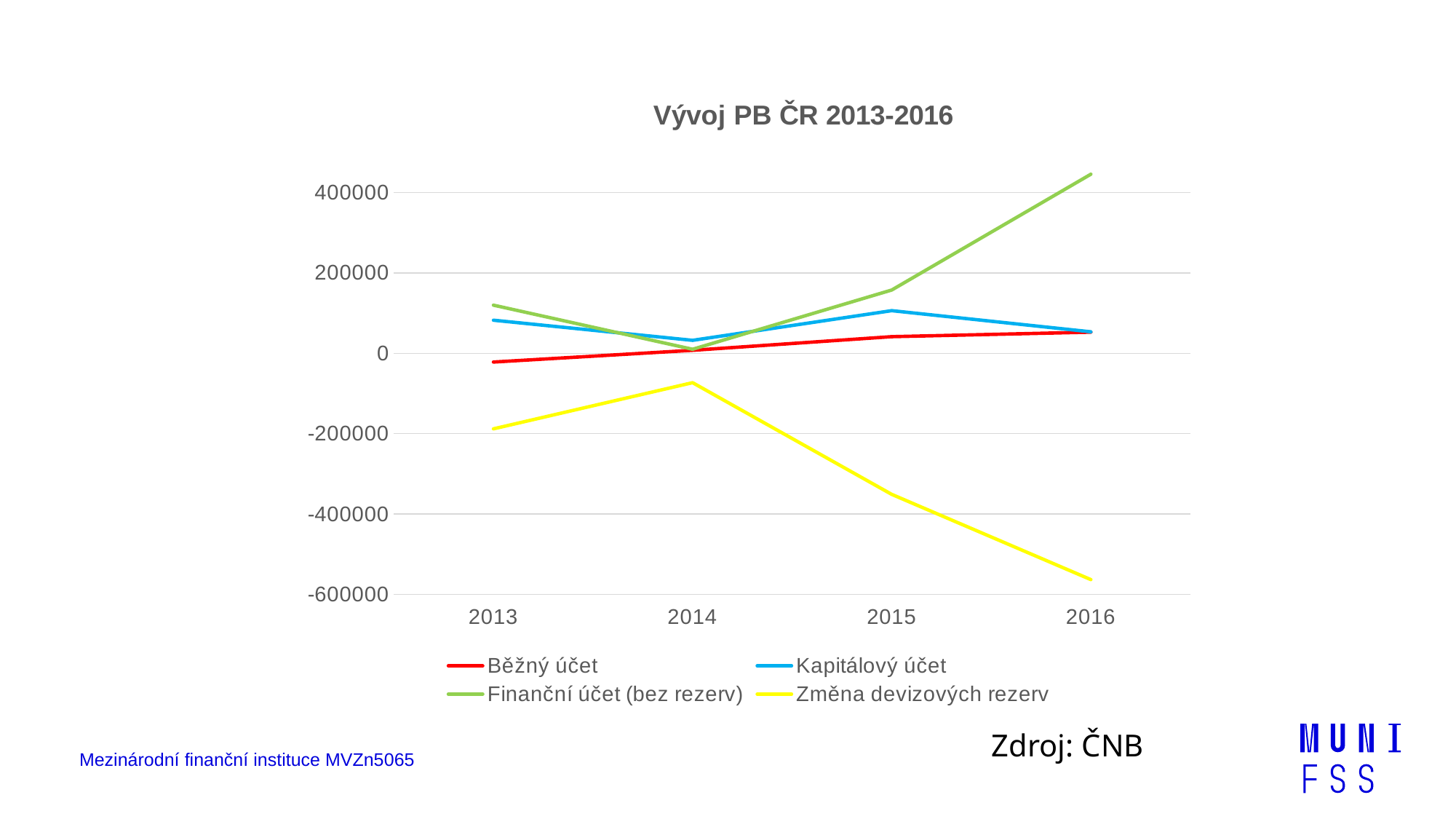
What is the title of the chart? Vývoj PB ČR 2013-2016 Is the value for Finanční účet (bez rezerv) in 2016 greater or less than 400000? greater How many years are plotted along the x axis? 4 How many series does the legend list? 4 What kind of chart is shown on the slide? line chart In which year does the Kapitálový účet series reach its highest value? 2015 Does the Běžný účet series rise or fall from 2013 to 2016? rise In 2013, which is higher: Finanční účet (bez rezerv) or Kapitálový účet? Finanční účet (bez rezerv) Does the Změna devizových rezerv series rise or fall from 2014 to 2016? fall Is the value for Změna devizových rezerv in 2015 greater or less than -200000? less In which year does the Změna devizových rezerv series reach its lowest value? 2016 In which year does the Finanční účet (bez rezerv) series reach its highest value? 2016